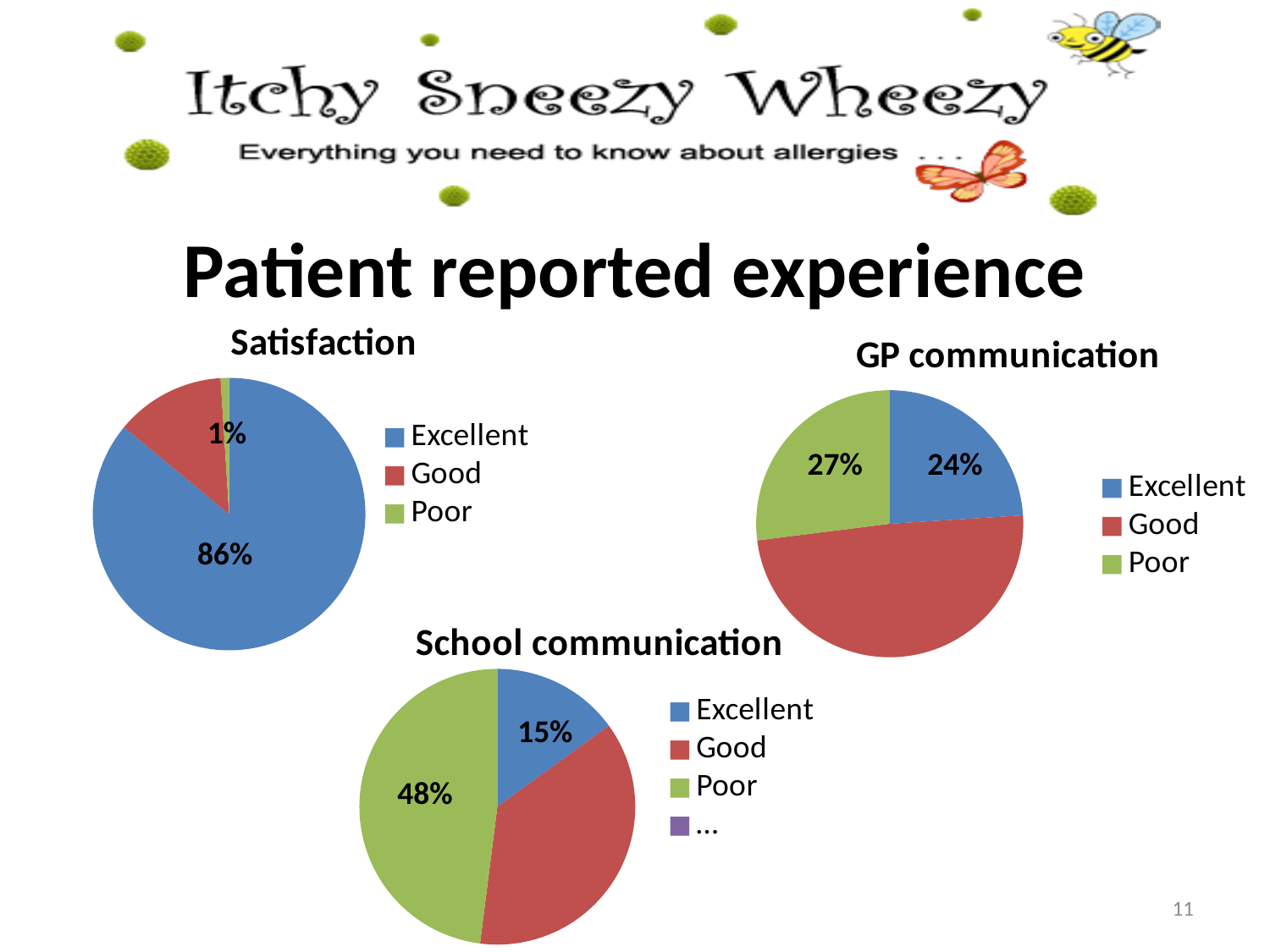
In the School communication chart, what share of responses is Poor? 48% In the School communication chart, which is larger, the Poor slice or the Excellent slice? Poor In the Satisfaction chart, what share of responses is Poor? 1% In the School communication chart, what share of responses is Excellent? 15% How many entries does the legend of the GP communication chart list? 3 In the Satisfaction chart, what share of responses is Excellent? 86% In the GP communication chart, what share of responses is Poor? 27% In the Satisfaction chart, which category has the largest slice? Excellent In the GP communication chart, what share of responses is Excellent? 24% What type of chart is the Satisfaction chart? Pie chart In the Satisfaction chart, which category has the smallest slice? Poor In the GP communication chart, which category has the largest slice? Good